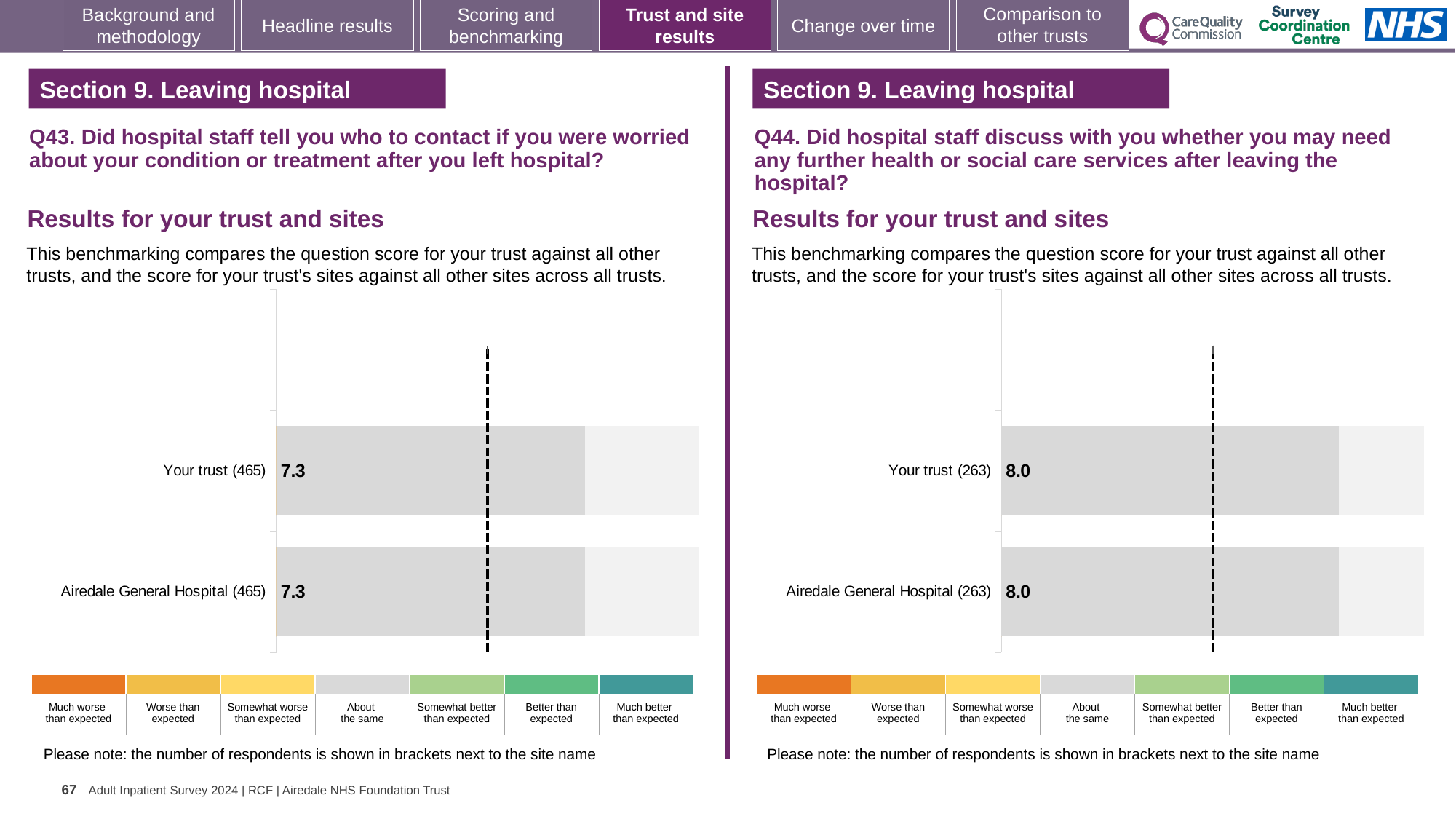
In the Q44 chart on the right, what is the score for Airedale General Hospital? 8.0 In the Q43 chart on the left, what is the difference between the score for Your trust and the score for Airedale General Hospital? 0.0 In the colour key below the Q43 chart on the left, which category is shown in orange at the far left? Much worse than expected How many bars are plotted in the Q44 chart on the right? 2 In the Q44 chart on the right, what is the score for Your trust? 8.0 In the Q43 chart on the left, what is the score for Your trust? 7.3 In the Q44 chart on the right, how many respondents are shown in brackets for Airedale General Hospital? 263 In the Q43 chart on the left, what is the score for Airedale General Hospital? 7.3 How many bars are plotted in the Q43 chart on the left? 2 In the Q43 chart on the left, how many respondents are shown in brackets for Your trust? 465 What kind of chart is used for the Q43 results on the left? Bar chart How many rating categories are shown in the colour key below the Q44 chart on the right? 7